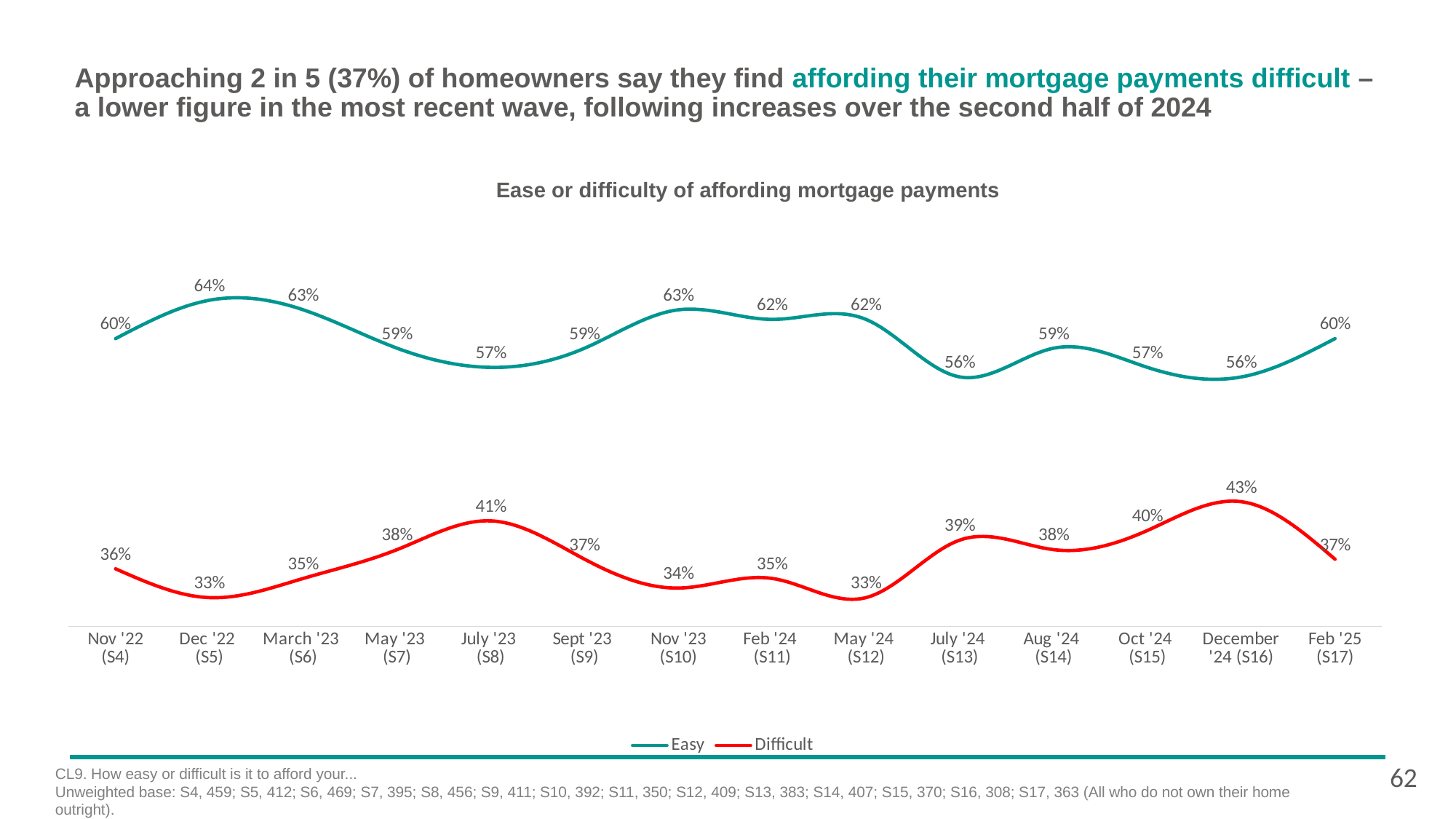
By how many percentage points did the Difficult value change from December '24 (S16) to Feb '25 (S17)? 6 percentage points What is the Difficult value for July '23 (S8)? 41% Which is larger: the Difficult value in July '23 (S8) or in Oct '24 (S15)? July '23 (S8) What is the Easy value for Dec '22 (S5)? 64% How many series does the legend list? 2 Did the Difficult series rise or fall between May '24 (S12) and December '24 (S16)? Rise In which wave does the Easy series reach its highest value? Dec '22 (S5) In which wave does the Difficult series reach its highest value? December '24 (S16) What percentage of homeowners said affording their mortgage payments was Difficult in Feb '25 (S17)? 37% What is the difference between the Easy and Difficult values in Feb '25 (S17)? 23 percentage points What type of chart is shown on the slide? Line chart How many waves (time points) are shown on the x axis? 14